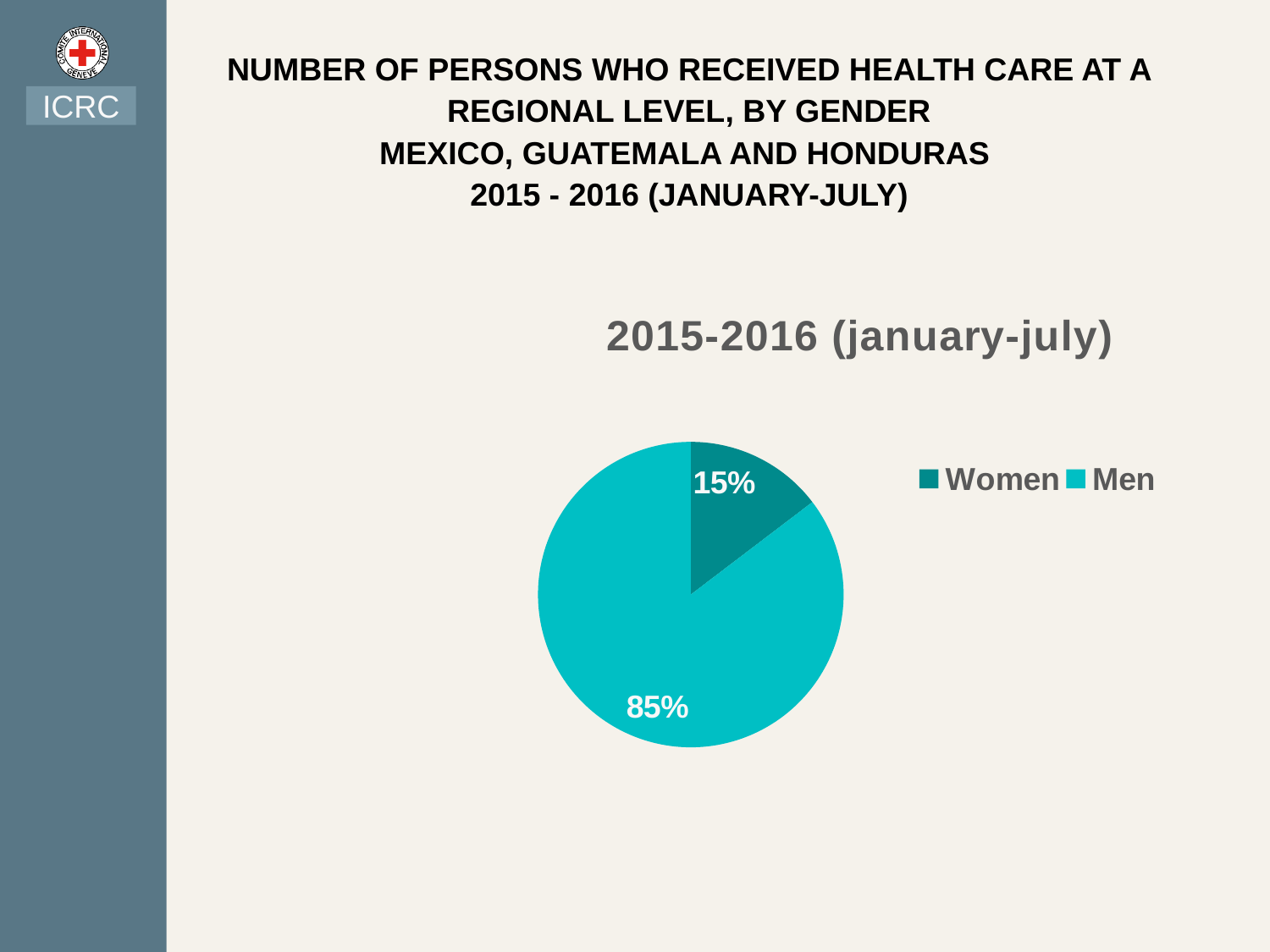
What kind of chart is shown on the slide? pie chart What is the total of the two percentages shown on the pie chart? 100% How many entries does the legend list? 2 Which category has the largest share of the pie chart? Men Which category has the smallest share of the pie chart? Women What is the difference in percentage points between the Men and Women shares? 70 Which share is larger, Women or Men? Men What is the title of the chart? 2015-2016 (january-july) What percentage of the pie chart is Women? 15% What percentage of the pie chart is Men? 85% How many slices does the pie chart have? 2 Which legend entry is shown in the lighter turquoise colour? Men